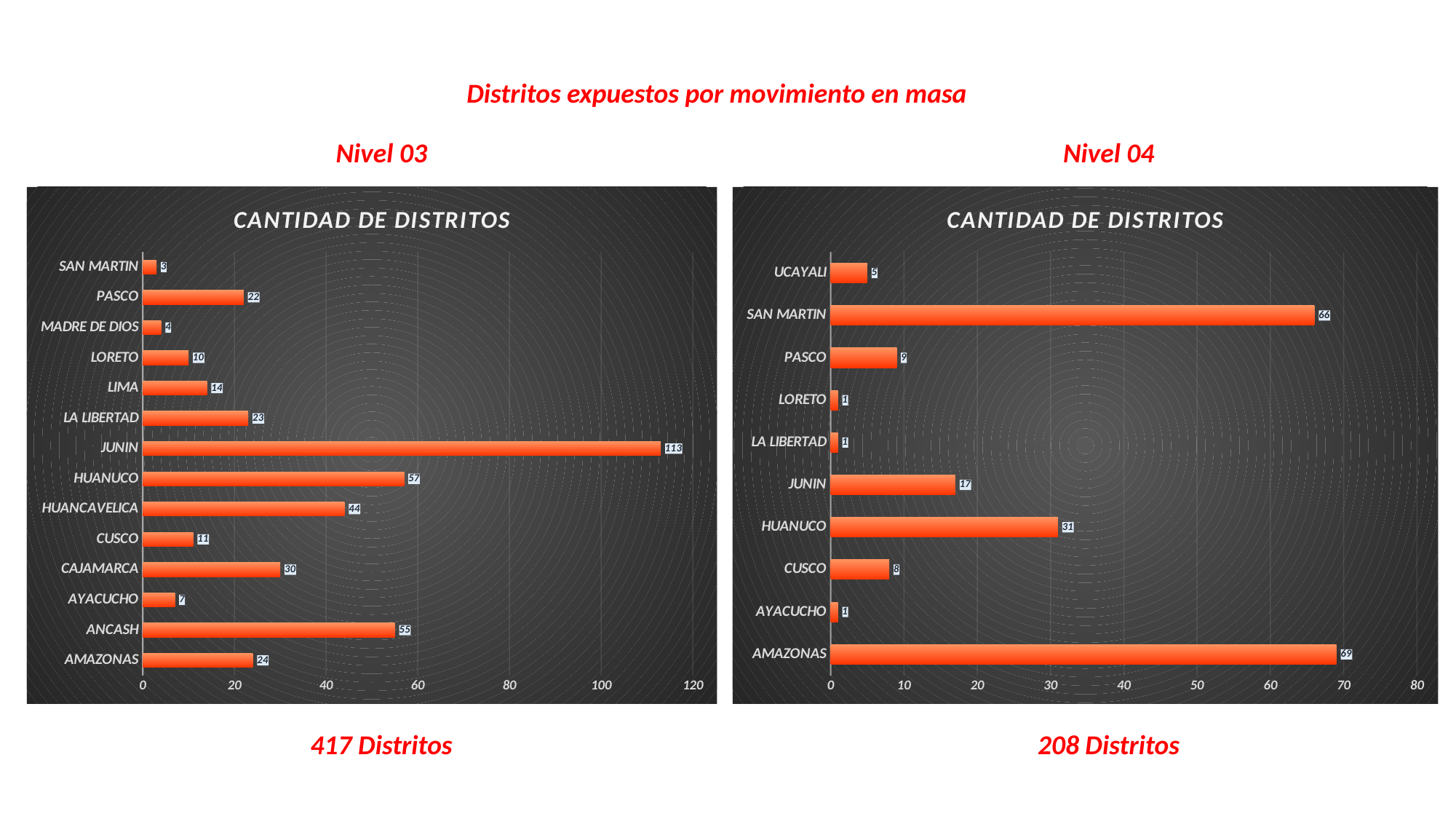
In the Nivel 03 chart, what is the value for JUNIN? 113 In the Nivel 03 chart, which is larger, the value for CAJAMARCA or the value for AMAZONAS? CAJAMARCA In the Nivel 04 chart, which category has the highest value? AMAZONAS How many categories are shown in the Nivel 04 chart? 10 In the Nivel 03 chart, which category has the highest value? JUNIN In the Nivel 04 chart, what is the difference between the values for AMAZONAS and SAN MARTIN? 3 In the Nivel 03 chart, what is the difference between the values for HUANUCO and ANCASH? 2 How many categories are shown in the Nivel 03 chart? 14 In the Nivel 04 chart, what is the value for HUANUCO? 31 In the Nivel 03 chart, which category has the lowest value? SAN MARTIN In the Nivel 04 chart, is the value for JUNIN greater or less than 20? less What type of chart is the Nivel 04 chart? Bar chart